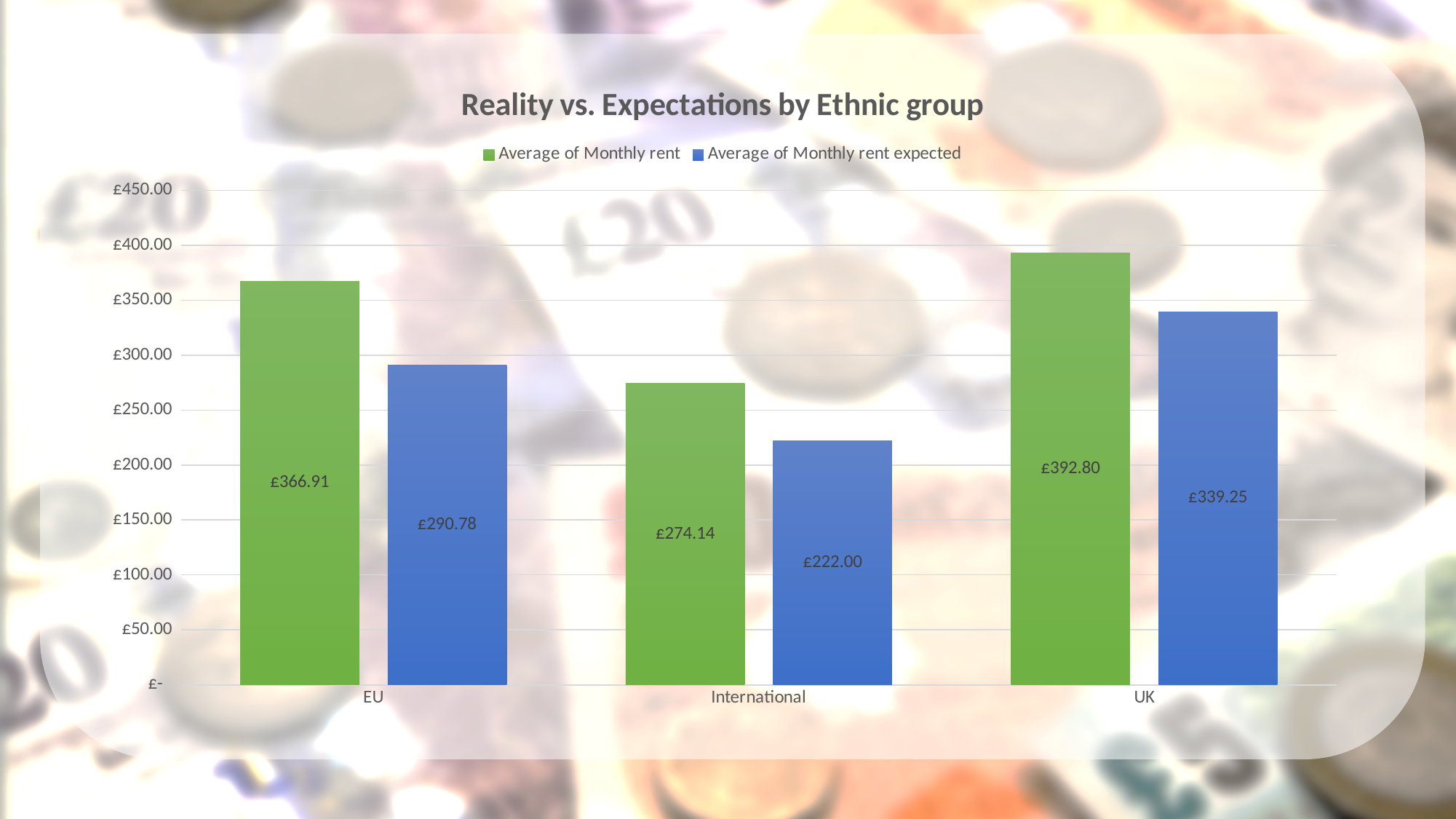
How many ethnic groups are shown on the x axis? 3 What type of chart is shown on the slide? Bar chart Which is larger for the International group: the Average of Monthly rent or the Average of Monthly rent expected? Average of Monthly rent What is the Average of Monthly rent expected for the International group? £222.00 How many series does the legend list? 2 What is the difference between the Average of Monthly rent and the Average of Monthly rent expected for the EU group? £76.13 What is the Average of Monthly rent expected for the UK group? £339.25 What is the Average of Monthly rent for the EU group? £366.91 How much higher is the Average of Monthly rent for the UK group than for the EU group? £25.89 Which group has the lowest Average of Monthly rent expected? International Which group has the highest Average of Monthly rent? UK Is the Average of Monthly rent expected for the EU group greater or less than £300.00? less